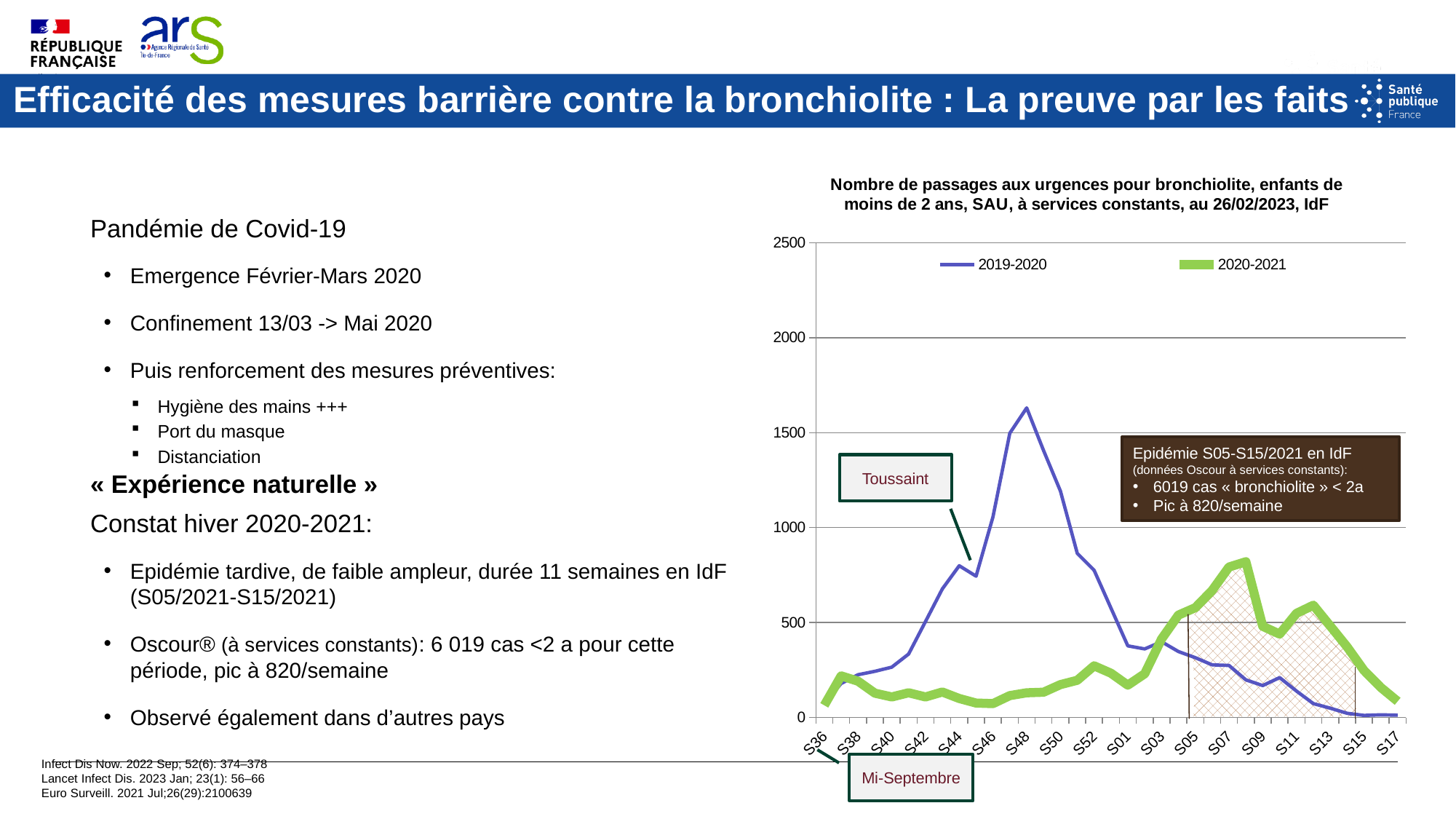
According to the annotation box, what was the weekly peak of the S05-S15/2021 epidemic? 820/semaine At which week does the 2019-2020 series reach its peak? S48 At week S48, which series has the larger value, 2019-2020 or 2020-2021? 2019-2020 Does the 2019-2020 series rise or fall between S48 and S15? fall Is the value of the 2019-2020 series at S36 greater or less than 500? less At which week does the 2020-2021 series reach its peak? S08 Is the peak value of the 2019-2020 series greater or less than 1500? greater Is the peak value of the 2020-2021 series greater or less than 1000? less Which series reaches the higher peak, 2019-2020 or 2020-2021? 2019-2020 What kind of chart is shown on the slide? line chart At week S07, which series has the larger value, 2019-2020 or 2020-2021? 2020-2021 How many series does the chart legend list? 2